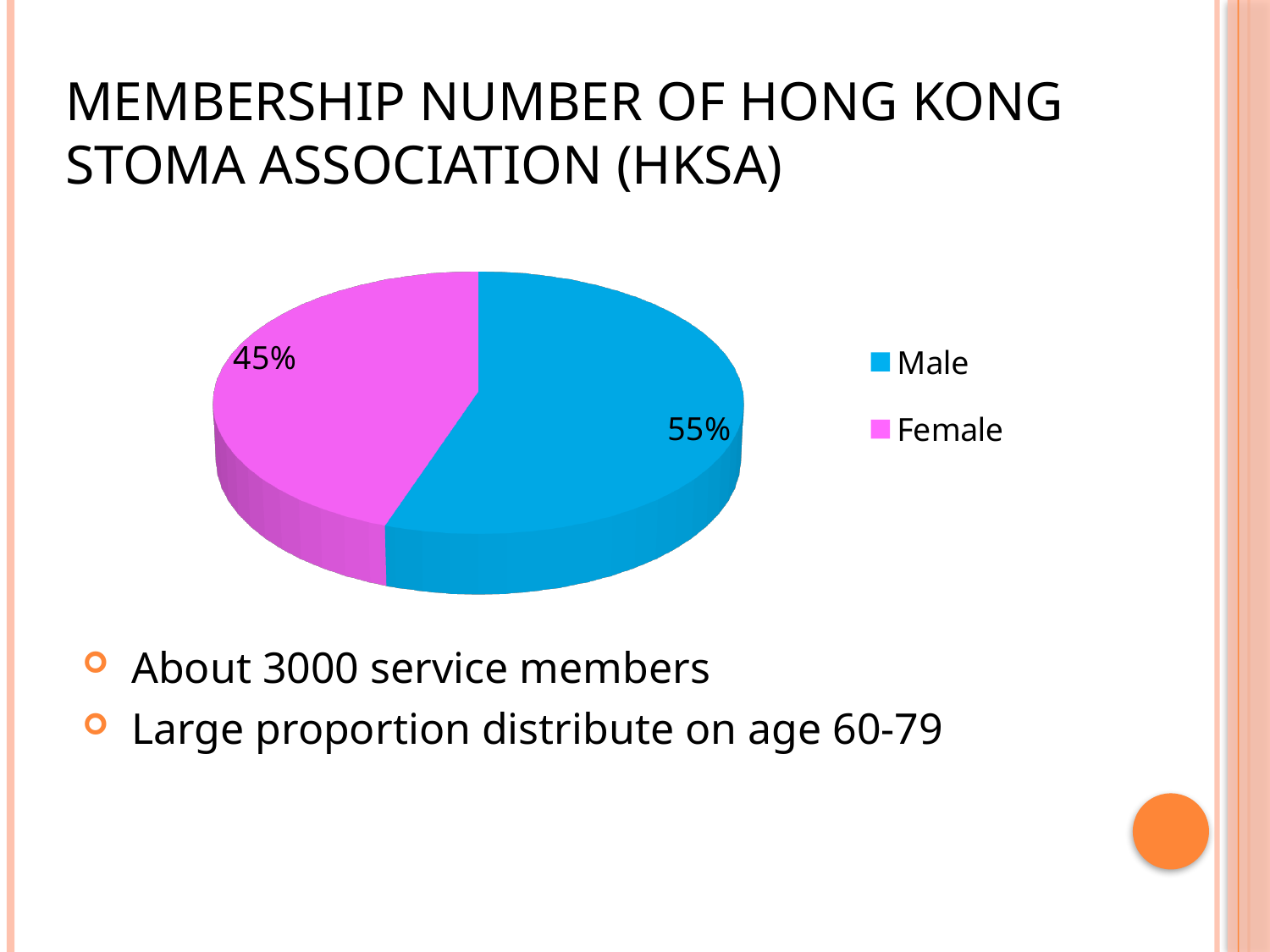
Which is larger in the pie chart, Male or Female? Male How many entries does the legend list? 2 Which slice of the pie chart is the largest? Male What share of the pie does the Female slice represent? 45% What is the difference in percentage points between the Male and Female slices? 10 How many slices does the pie chart have? 2 Which slice of the pie chart is the smallest? Female What percentage of the pie chart is Male? 55% What colour is the Female slice in the pie chart? Pink What colour is the Male slice in the pie chart? Blue What kind of chart is shown on the slide? Pie chart What percentage of the pie chart is Female? 45%